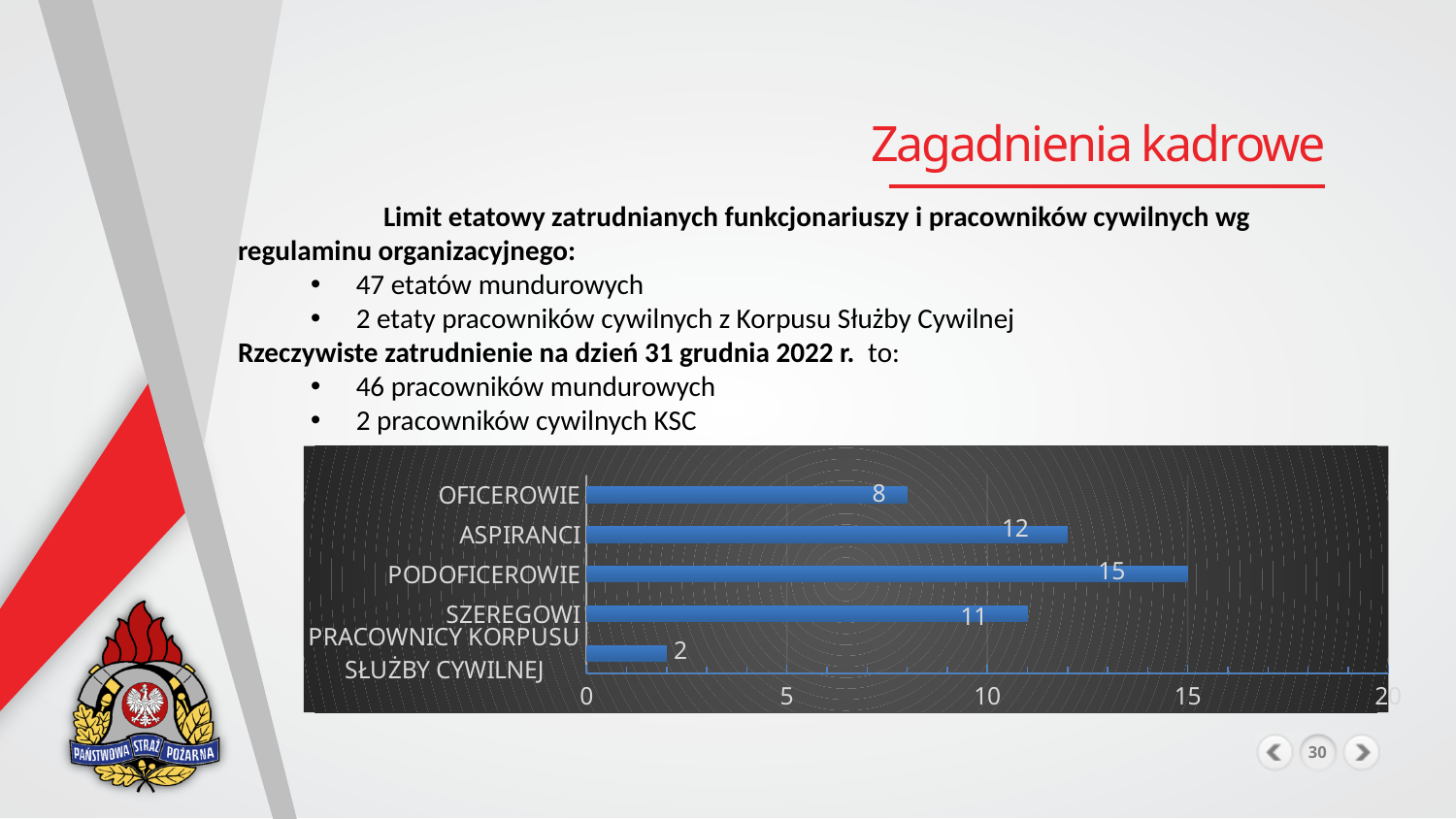
What is the total of all the values shown in the chart? 48 Which category has the highest value? PODOFICEROWIE What is the value for ASPIRANCI? 12 Which category has the lowest value? PRACOWNICY KORPUSU SŁUŻBY CYWILNEJ What is the value for SZEREGOWI? 11 What is the value for PODOFICEROWIE? 15 What is the difference between the values for PODOFICEROWIE and OFICEROWIE? 7 How many categories are shown in the chart? 5 What is the value for PRACOWNICY KORPUSU SŁUŻBY CYWILNEJ? 2 Which is larger, the value for ASPIRANCI or the value for SZEREGOWI? ASPIRANCI What kind of chart is shown on the slide? bar chart Is the value for OFICEROWIE greater or less than 10? less